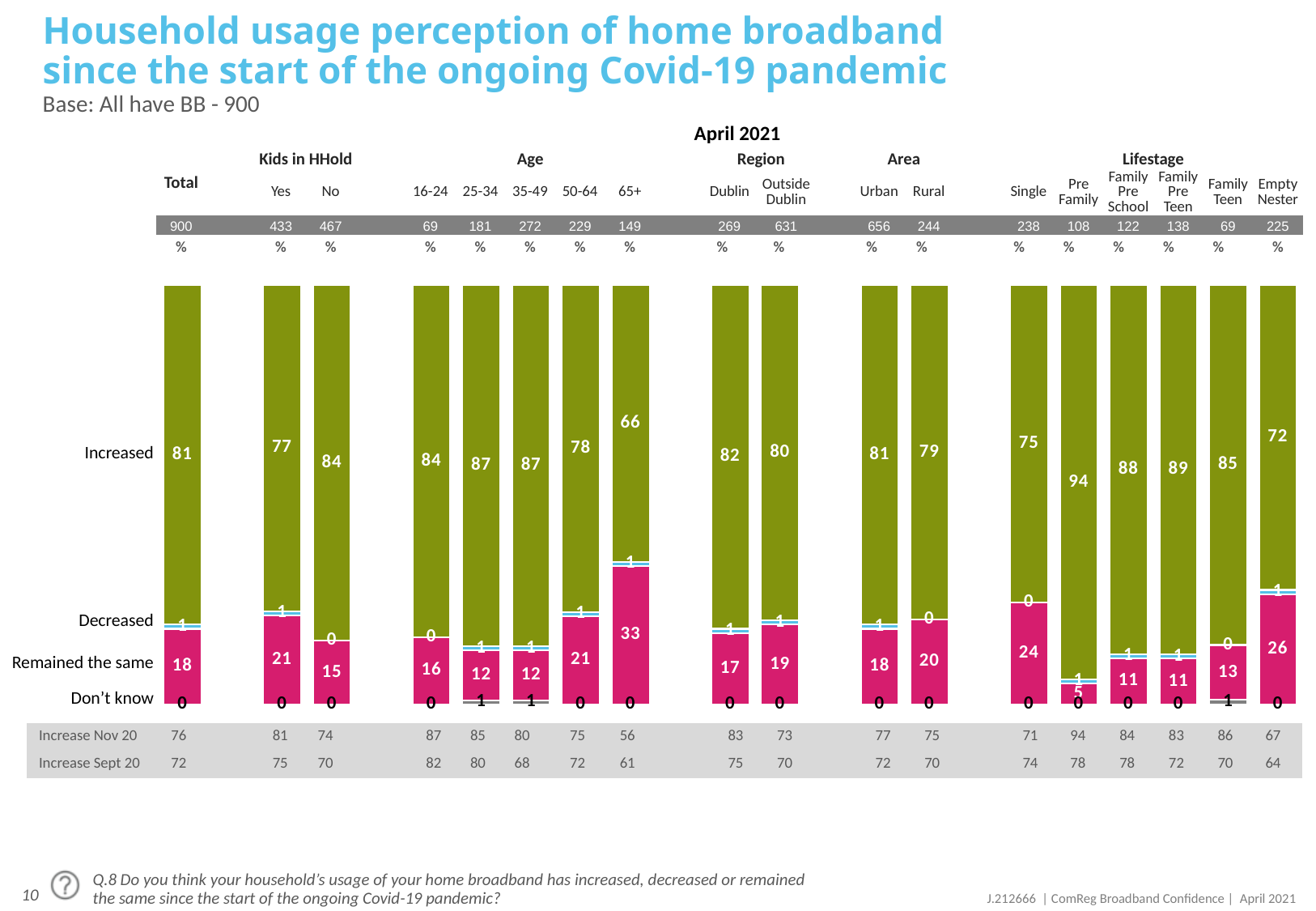
What percentage of the 65+ age group said their usage Remained the same? 33 Which has a larger Increased value, Urban or Rural? Urban What percentage of the Total group said their home broadband usage Increased? 81 What is the Increased value for the 'Yes' Kids in HHold group? 77 What is the difference between the Remained the same values for Empty Nester and Family Teen? 13 What kind of chart is shown on the slide? Stacked bar chart How many categories (bars) are shown in the chart? 18 Which response category is shown in green in the chart? Increased What is the Remained the same value for Single? 24 What is the difference between the Increased values for Dublin and Outside Dublin? 2 Which category has the highest Increased value? Pre Family Which category has the lowest Increased value? 65+